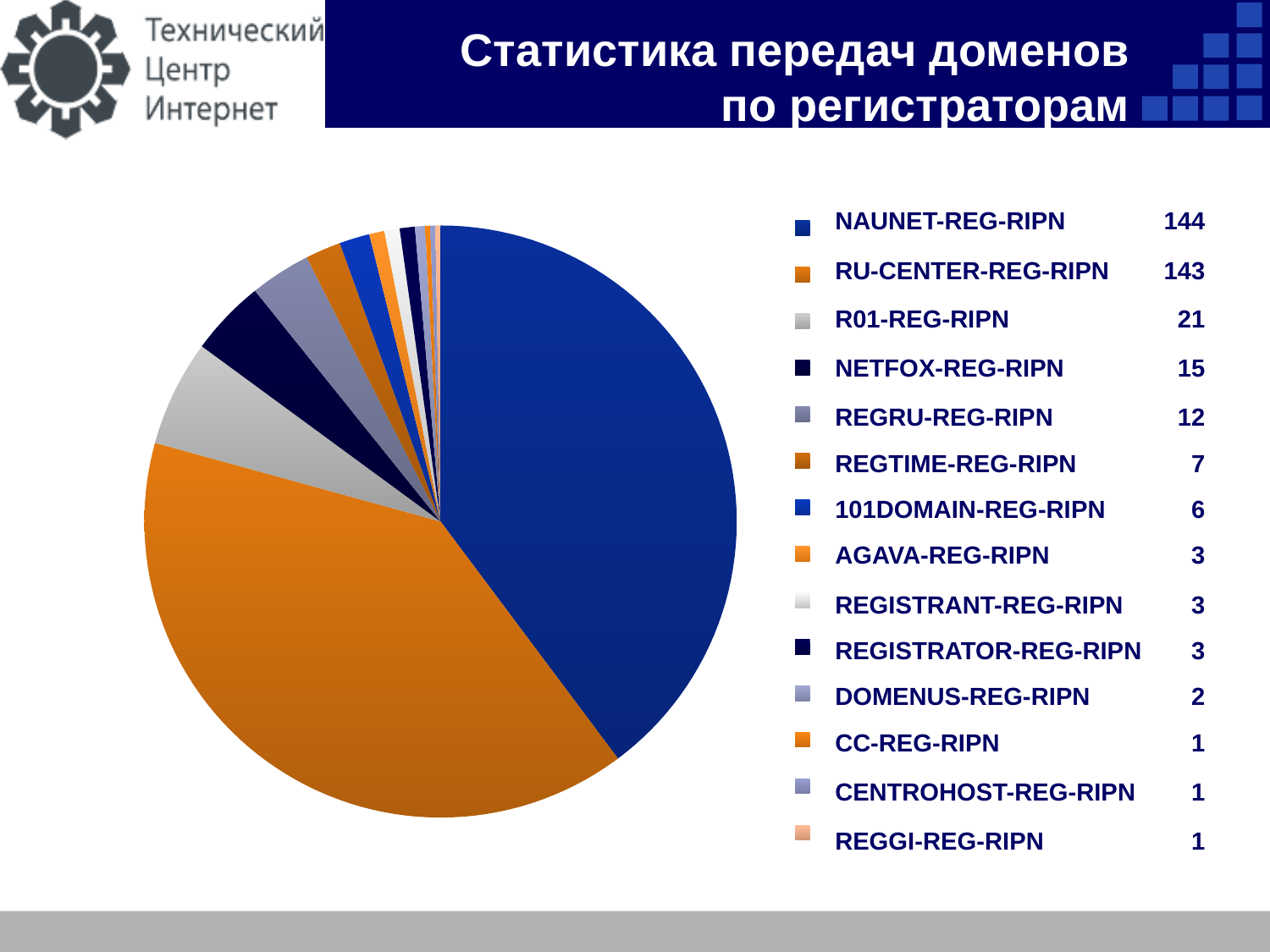
What is the difference between the values for NAUNET-REG-RIPN and RU-CENTER-REG-RIPN? 1 How many registrars have a value of 1? 3 What is the value for REGRU-REG-RIPN? 12 How many registrars are listed in the legend? 14 Which is larger, the value for REGTIME-REG-RIPN or the value for 101DOMAIN-REG-RIPN? REGTIME-REG-RIPN What is the title of the slide? Статистика передач доменов по регистраторам What kind of chart is shown on the slide? pie chart What is the value for NAUNET-REG-RIPN? 144 What is the total of all the values listed in the legend? 362 What is the difference between the values for R01-REG-RIPN and NETFOX-REG-RIPN? 6 Which registrar has the highest value? NAUNET-REG-RIPN What is the value for R01-REG-RIPN? 21